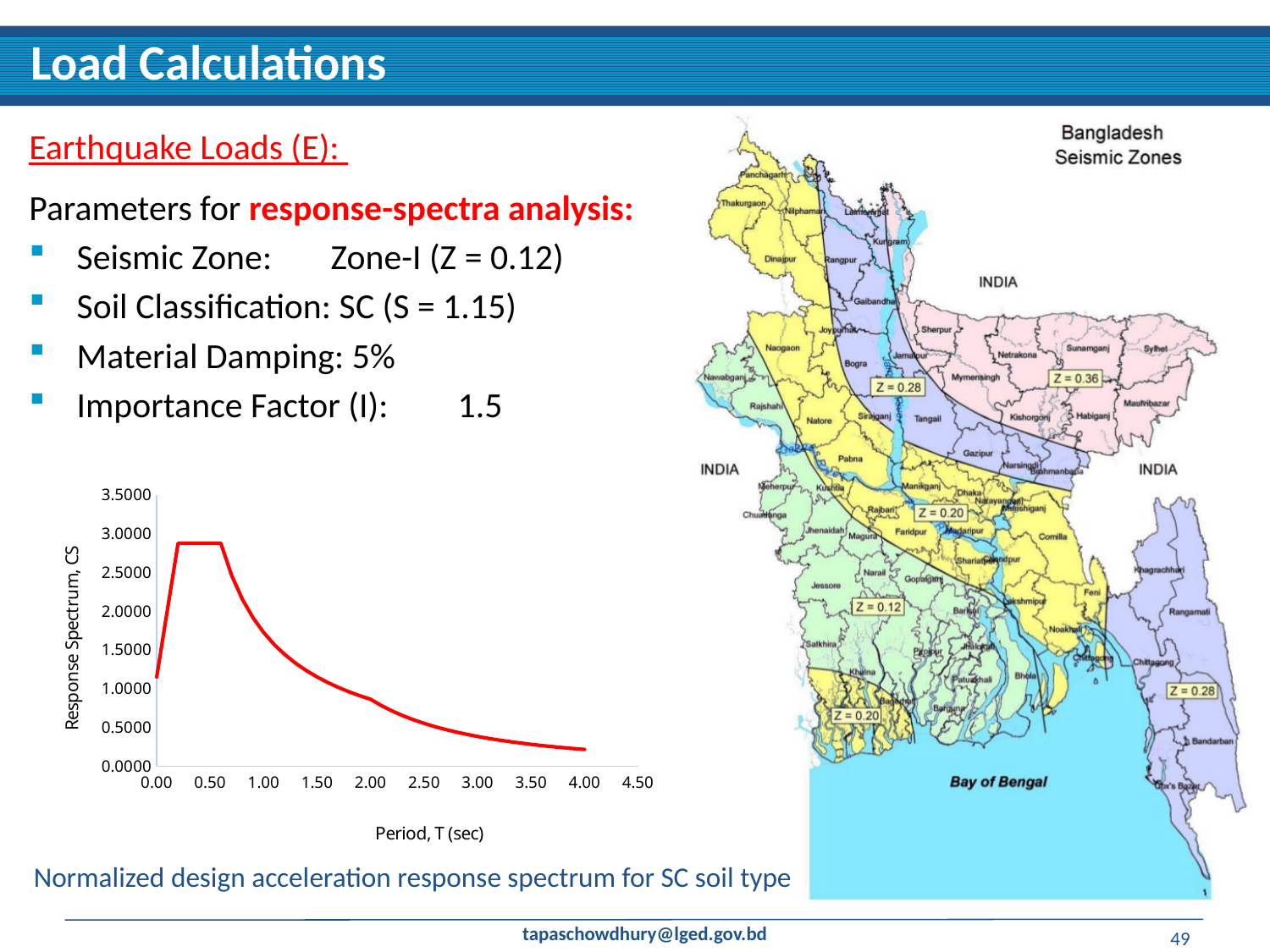
Is the value of the response spectrum at a period of 0.50 sec greater or less than 2.5000? greater What kind of chart is shown on the slide? line chart Does the response spectrum rise or fall as the period increases from 1.00 sec to 4.00 sec? fall Is the value of the response spectrum at a period of 0.00 sec greater or less than 1.0000? greater What is the title of the y axis of the chart? Response Spectrum, CS Is the value of the response spectrum at a period of 1.00 sec greater or less than 1.5000? greater What is the highest value shown on the y axis of the chart? 3.5000 Which is larger, the response spectrum at a period of 0.50 sec or at a period of 3.00 sec? 0.50 sec What is the title of the x axis of the chart? Period, T (sec)